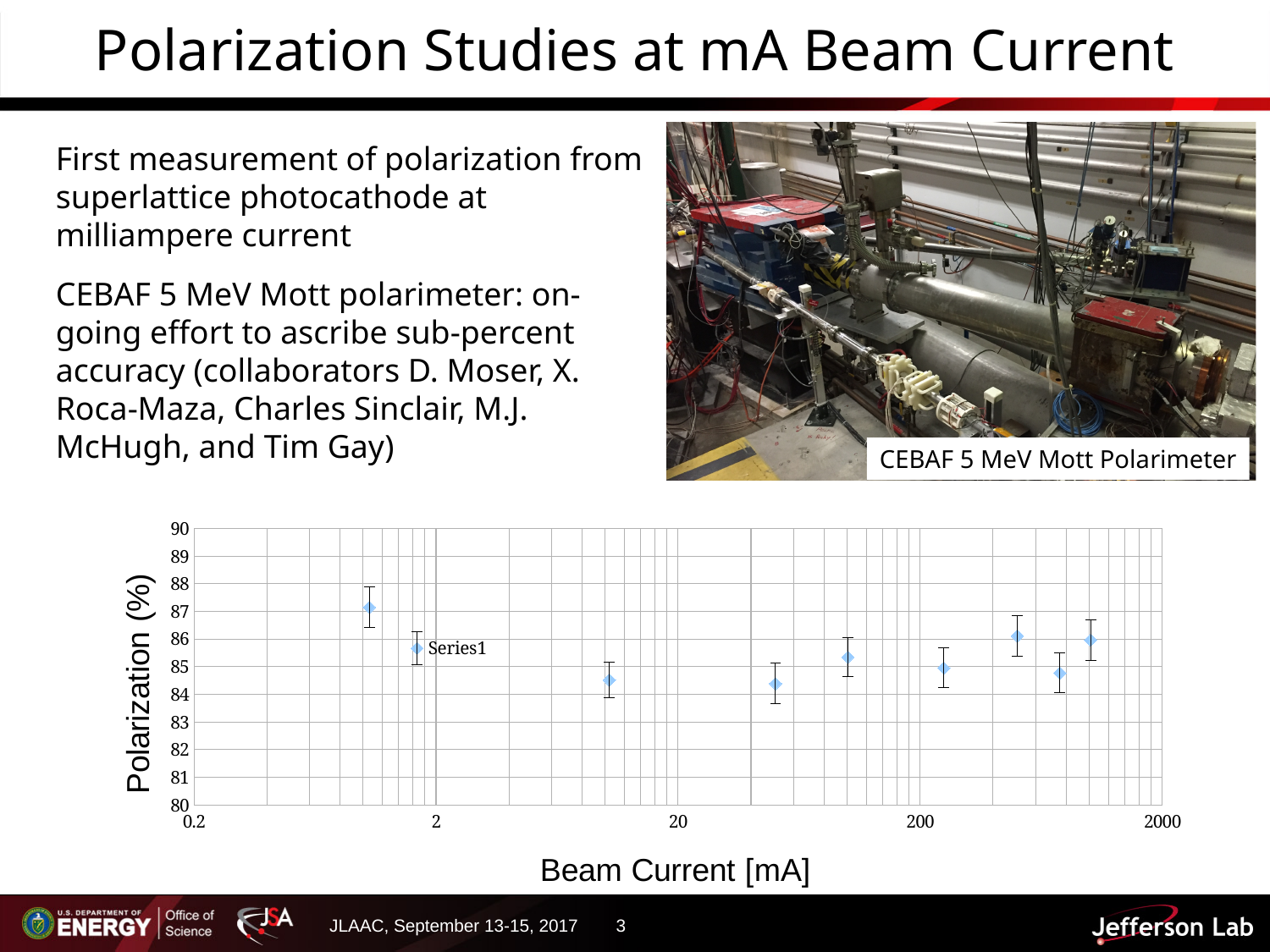
Which data point has the highest polarization value? the leftmost point (lowest beam current) How many series does the chart show? 1 Is the polarization value of the leftmost data point greater or less than 86? greater Which has the larger polarization value: the leftmost data point or the rightmost data point? the leftmost data point What kind of chart is shown on the slide? scatter plot What is the title of the y axis of the chart? Polarization (%) Are all plotted polarization values greater or less than 88? less How many data points are plotted in the chart? 9 Is the polarization value of the data point near 10 mA greater or less than 85? less Do the polarization values rise or fall across the first three data points from left to right? fall What is the title of the x axis of the chart? Beam Current [mA]